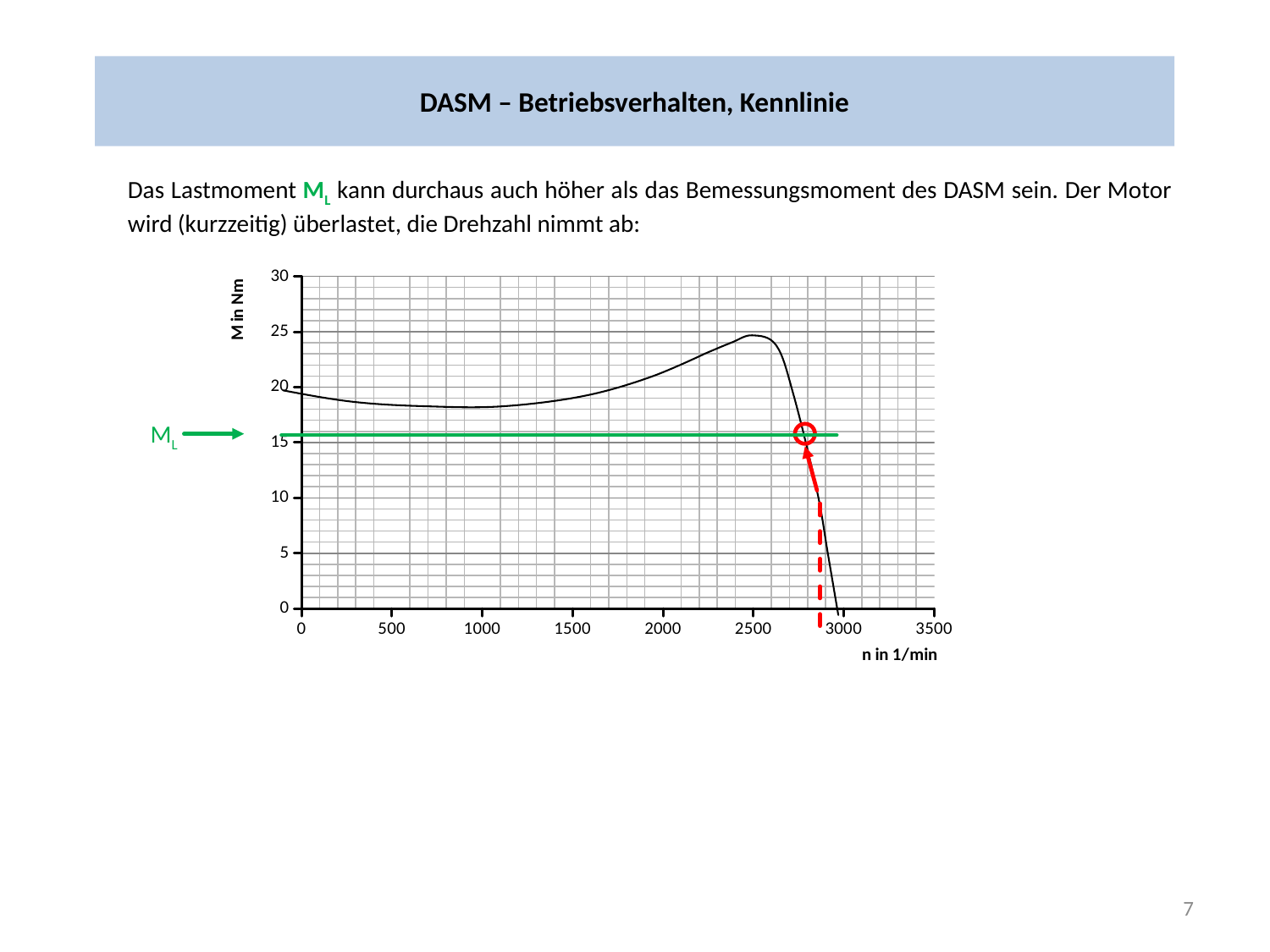
What kind of chart is shown on the slide? line chart Is the value of the curve at n = 2000 greater or less than 25? less What is the label of the vertical axis of the chart? M in Nm Does the curve rise or fall between n = 2500 and n = 3000? fall At which labelled x-axis tick does the curve reach its highest value? 2500 How many labelled tick marks are on the horizontal axis? 8 Is the value of the curve at n = 1000 greater or less than 20? less What is the label of the horizontal axis of the chart? n in 1/min Is the green M_L line above or below 20 Nm? below Which is larger, the curve value at n = 0 or at n = 1000? n = 0